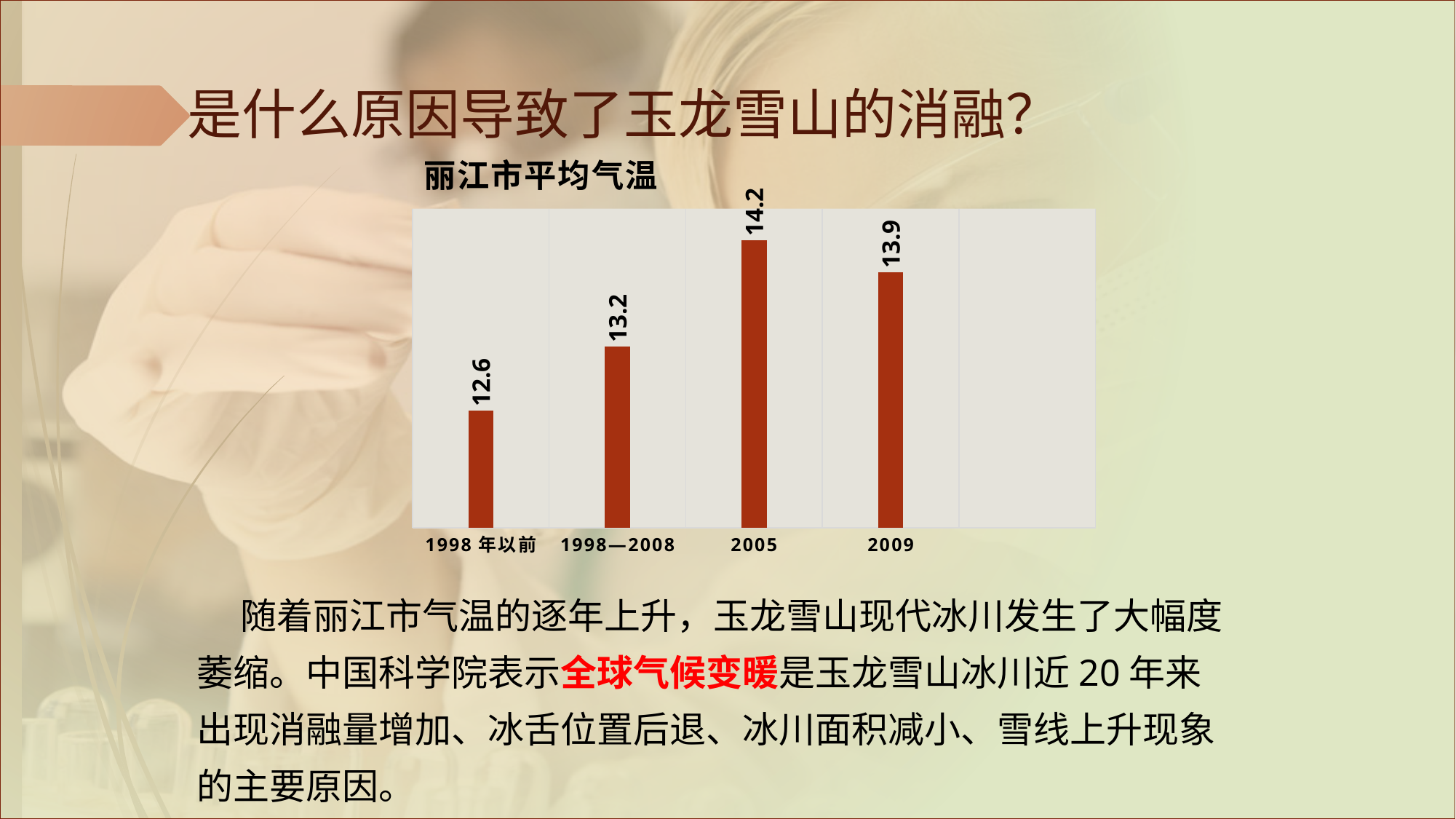
What is the value for 1998—2008 in the 丽江市平均气温 chart? 13.2 How many categories are shown in the 丽江市平均气温 chart? 4 What is the difference between the values for 2005 and 1998 年以前 in the 丽江市平均气温 chart? 1.6 What kind of chart is the 丽江市平均气温 chart? bar chart What is the value for 2009 in the 丽江市平均气温 chart? 13.9 What is the title of the chart on the slide? 丽江市平均气温 What is the value for 1998 年以前 in the 丽江市平均气温 chart? 12.6 What is the value for 2005 in the 丽江市平均气温 chart? 14.2 Which is larger in the 丽江市平均气温 chart, the value for 1998—2008 or the value for 2009? 2009 Which category has the highest value in the 丽江市平均气温 chart? 2005 Which category has the lowest value in the 丽江市平均气温 chart? 1998 年以前 What is the difference between the values for 2005 and 2009 in the 丽江市平均气温 chart? 0.3